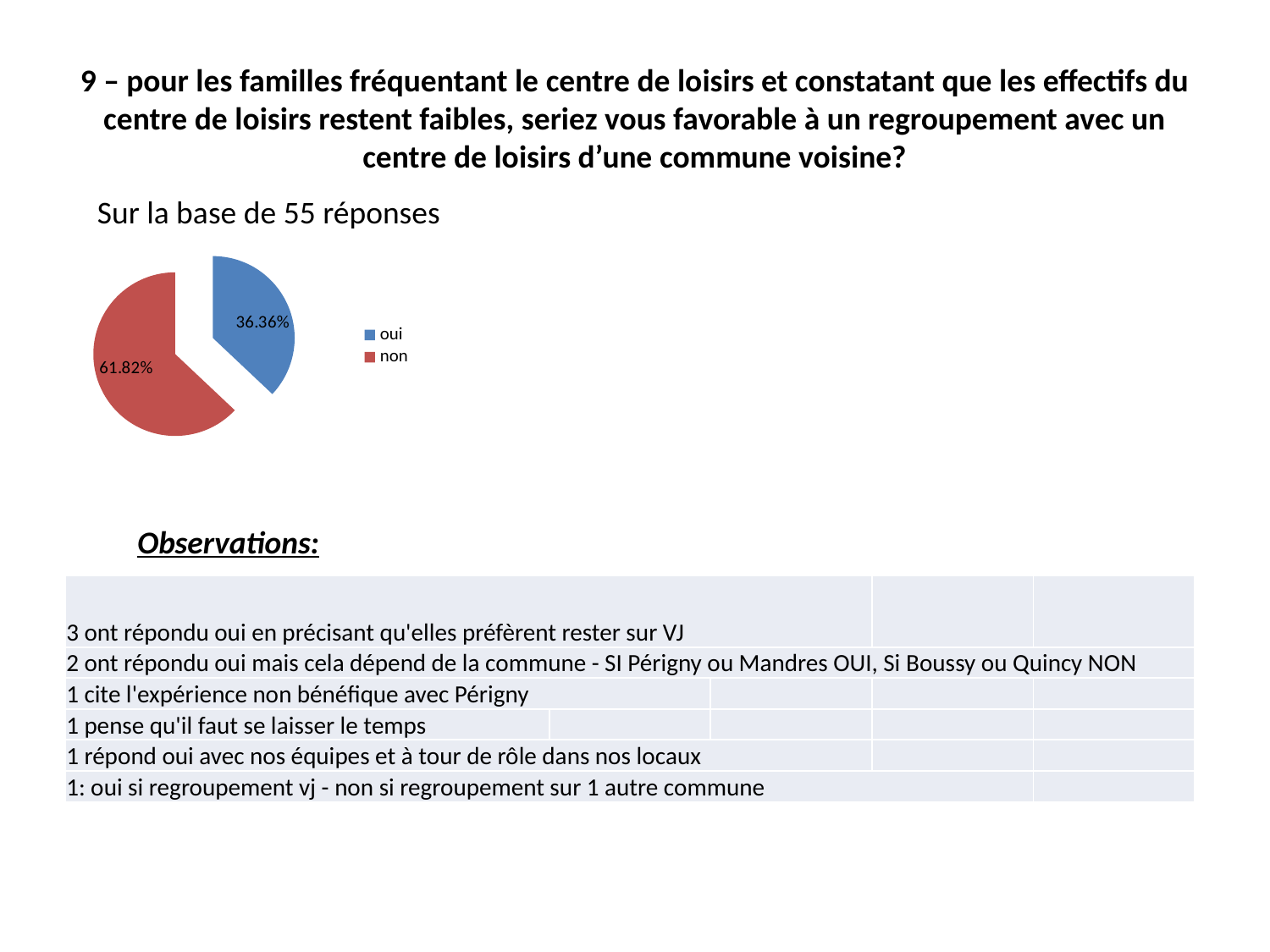
Which is larger, the share for "oui" or the share for "non"? non What colour is the "oui" slice? blue Which slice of the pie is the smallest? oui How many entries does the legend list? 2 What kind of chart is shown on the slide? pie chart What share of the pie does "oui" represent? 36.36% What colour is the "non" slice? red Which slice of the pie is the largest? non What share of the pie does "non" represent? 61.82% What is the difference in percentage points between the "non" share and the "oui" share? 25.46 How many slices does the pie chart have? 2